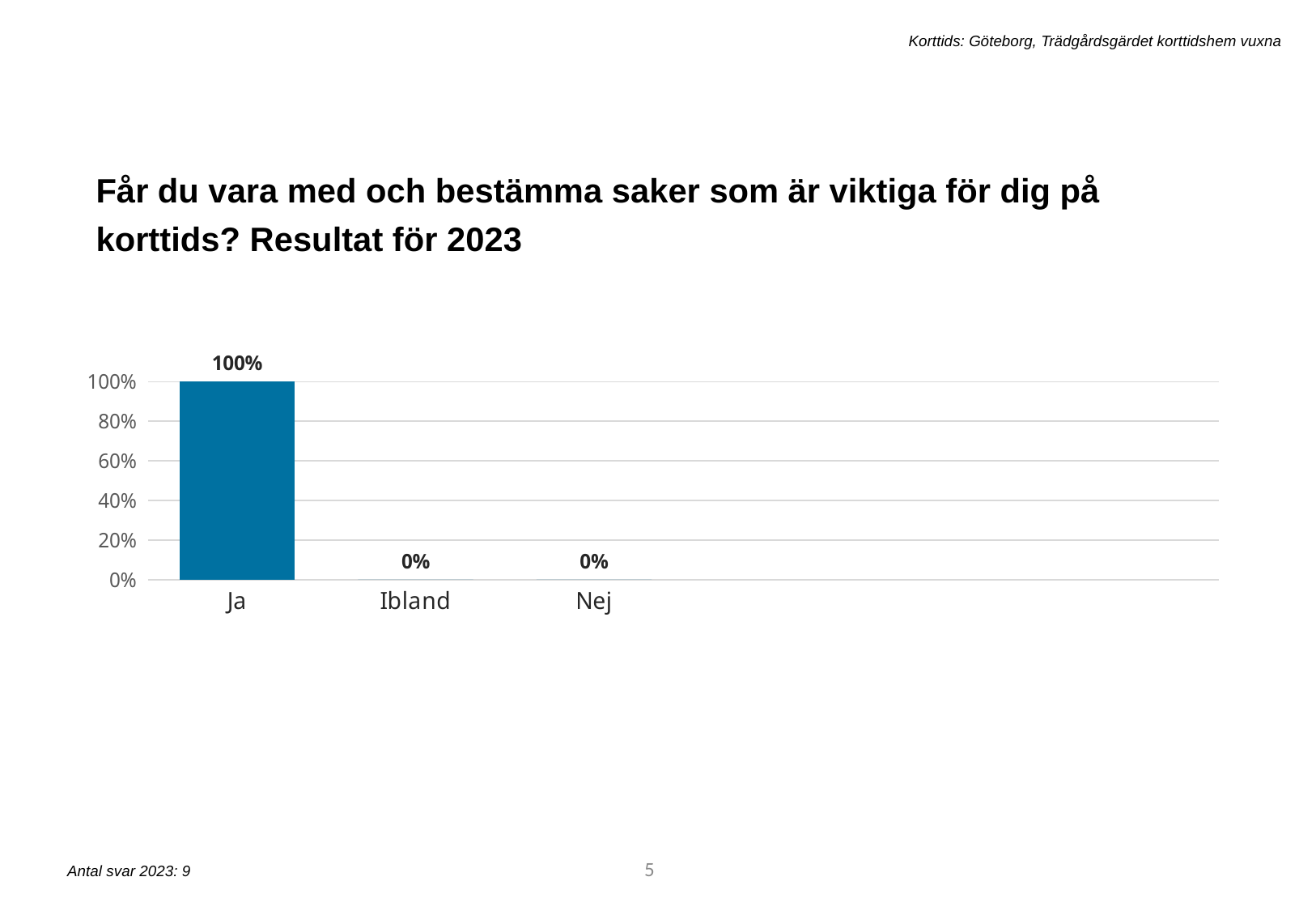
Which is larger, the value for Ja or the value for Ibland? Ja What is the difference between the values for Ja and Nej? 100% How many categories are shown on the x axis? 3 What is the highest tick value shown on the y axis? 100% What is the value for Ibland? 0% Is the value for Ja greater or less than 80%? greater Do the values rise or fall from Ja to Nej along the x axis? fall What colour is the bar for Ja? blue What is the value for Ja? 100% What kind of chart is shown on the slide? bar chart What is the value for Nej? 0% Which category has the highest value? Ja